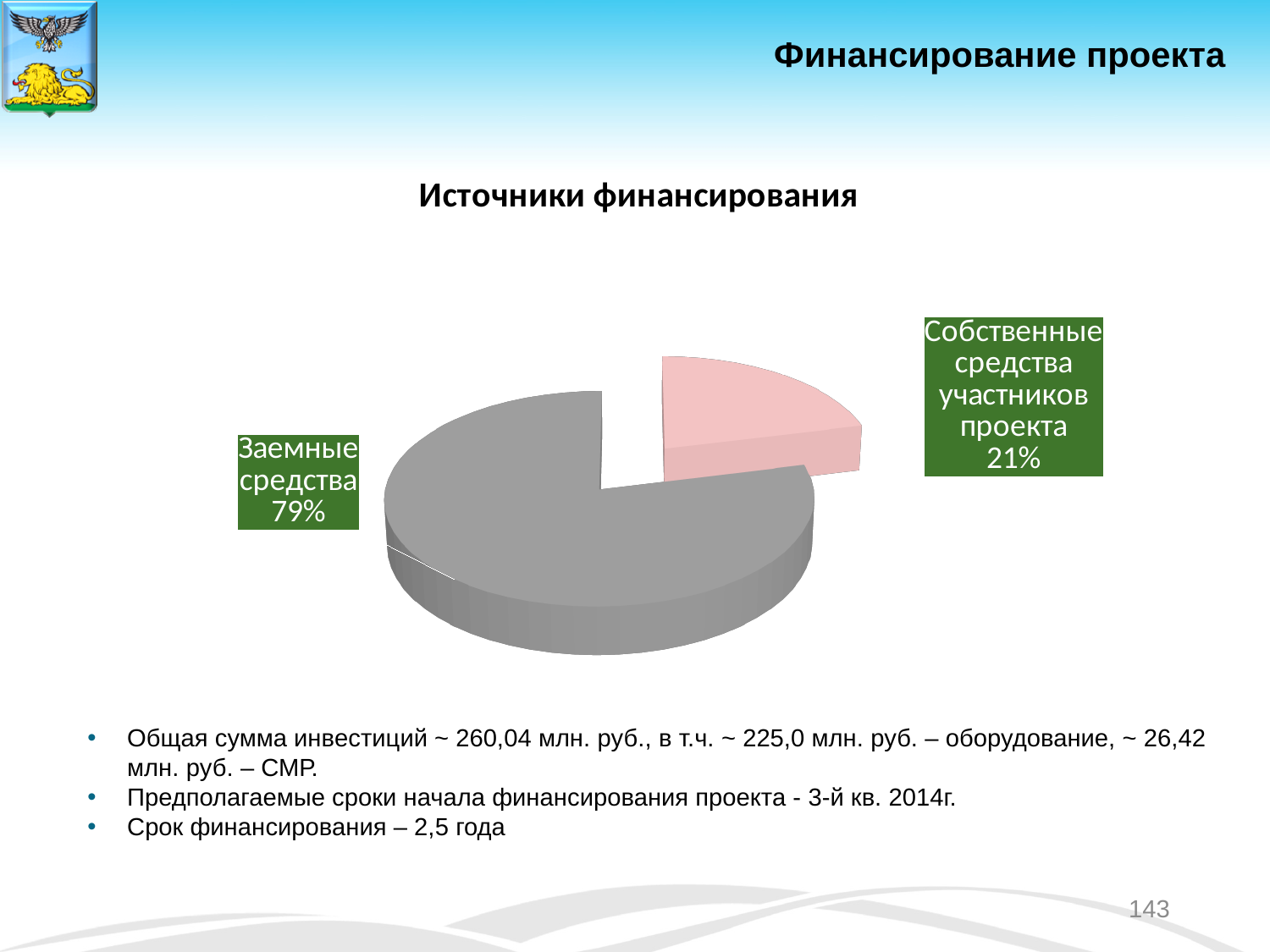
Which category has the smallest slice of the pie? Собственные средства участников проекта What share of the pie does "Собственные средства участников проекта" represent? 21% What is the difference in percentage points between the share of "Заемные средства" and "Собственные средства участников проекта"? 58 What colour is the slice for "Собственные средства участников проекта"? Pink Which category has the largest slice of the pie? Заемные средства What is the title of the chart? Источники финансирования How many slices does the pie chart have? 2 What kind of chart is shown on the slide? Pie chart Which is larger: the share of "Заемные средства" or the share of "Собственные средства участников проекта"? Заемные средства What share of the pie does "Заемные средства" represent? 79%